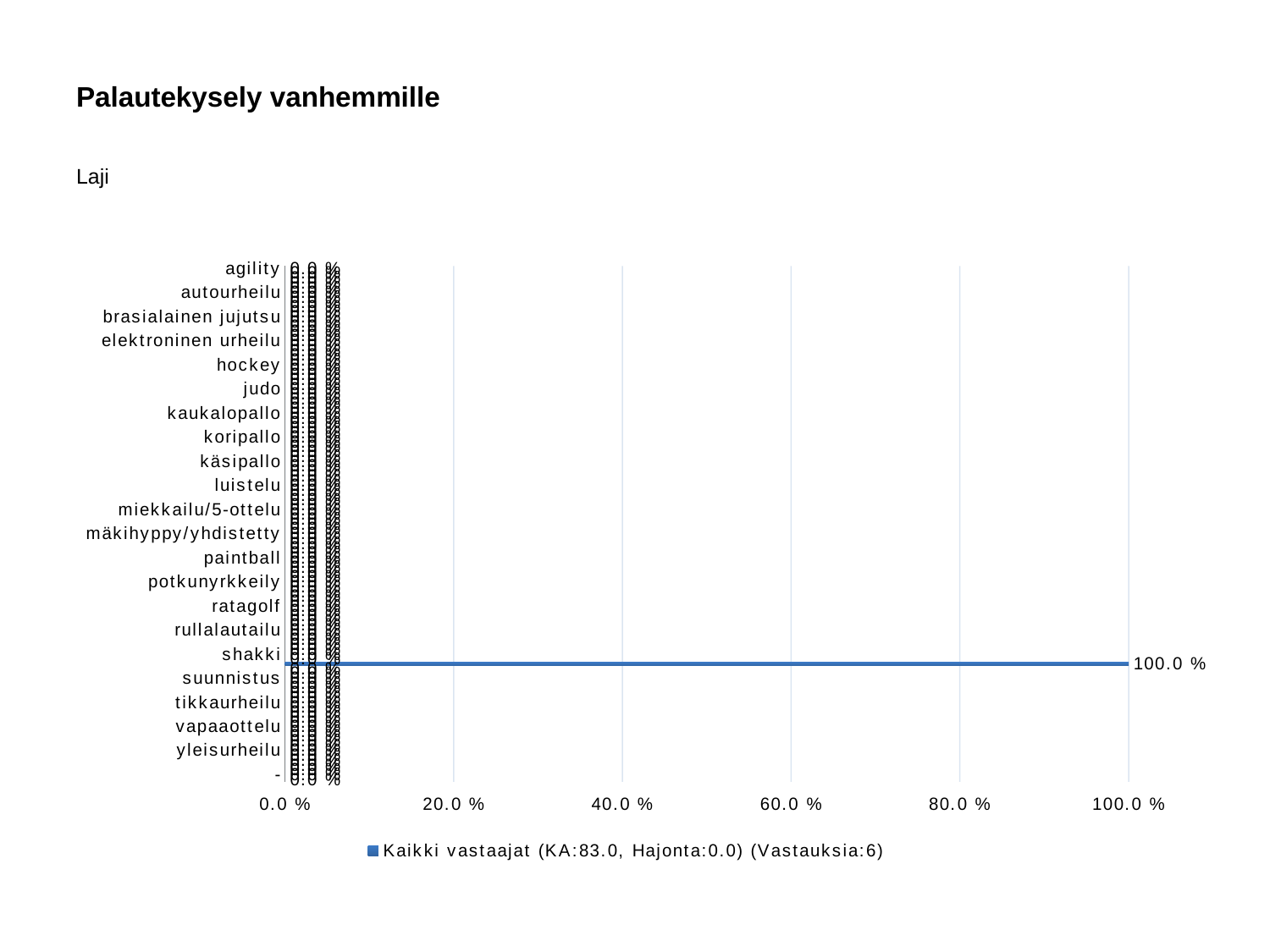
Is the value for hockey greater or less than 20.0 %? less What is the value shown for the longest bar in the chart? 100.0 % How many series does the chart legend list? 1 What kind of chart is shown on the slide? bar chart What is the value shown for agility? 0.0 % Which is larger, the value for shakki or the value for koripallo? Neither; both are 0.0 % What is the value shown for judo? 0.0 % What is the difference between the value for shakki and the value for yleisurheilu? 0.0 % What is the title of the slide? Palautekysely vanhemmille What is the legend entry of the chart? Kaikki vastaajat (KA:83.0, Hajonta:0.0) (Vastauksia:6)